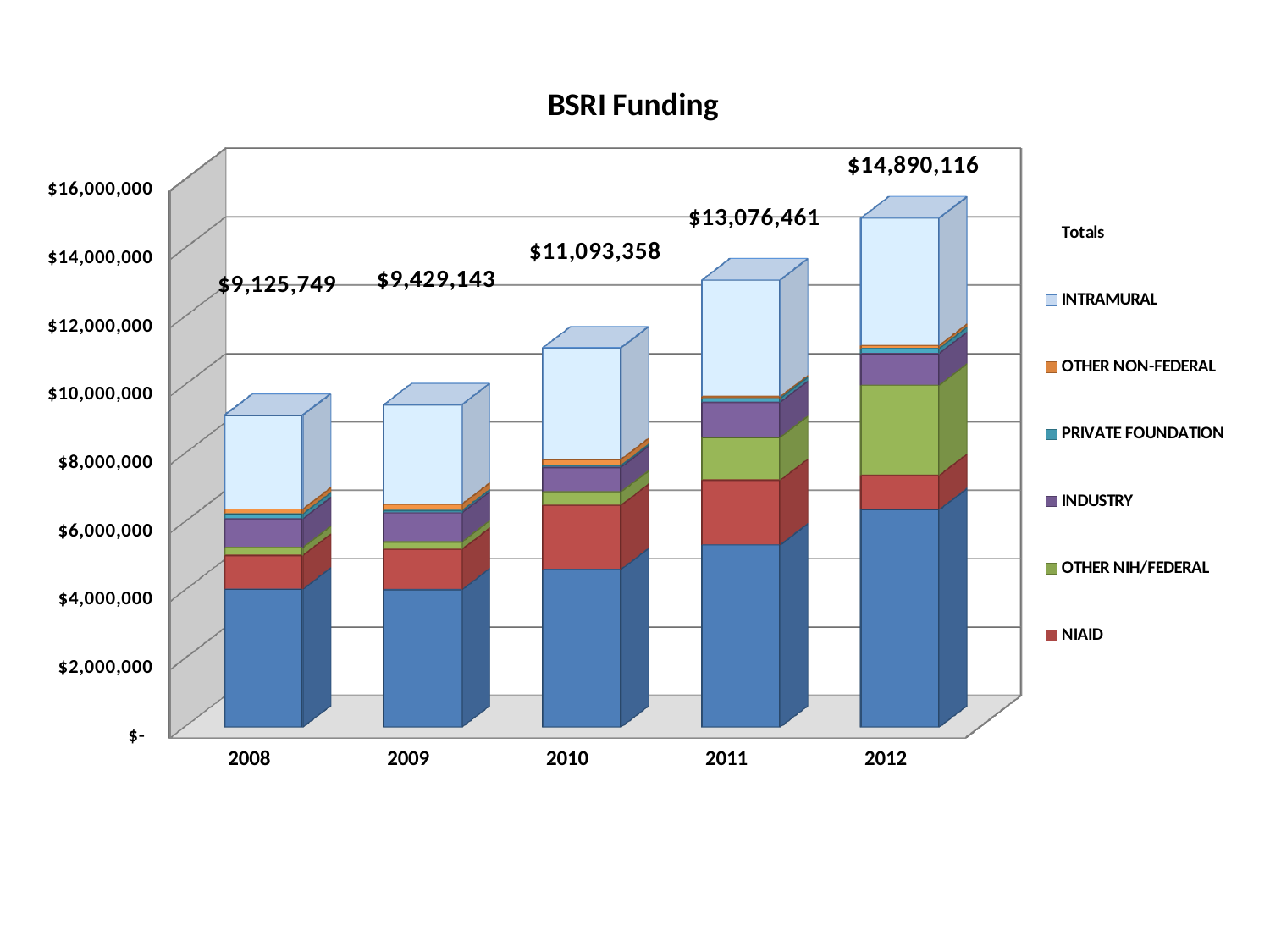
Is the total funding for 2010 greater or less than $10,000,000? greater What is the difference between the total funding in 2012 and in 2008? $5,764,367 Which year has the highest total BSRI funding? 2012 What is the total BSRI funding shown for 2010? $11,093,358 Which year has the larger total funding, 2009 or 2011? 2011 What kind of chart is shown on the slide? Stacked bar chart Which year has the lowest total BSRI funding? 2008 What is the difference between the total funding in 2011 and in 2010? $1,983,103 Do the total funding values rise or fall from 2008 to 2012? Rise What is the total BSRI funding shown for 2008? $9,125,749 What is the total BSRI funding shown for 2012? $14,890,116 How many years are shown on the x axis? 5